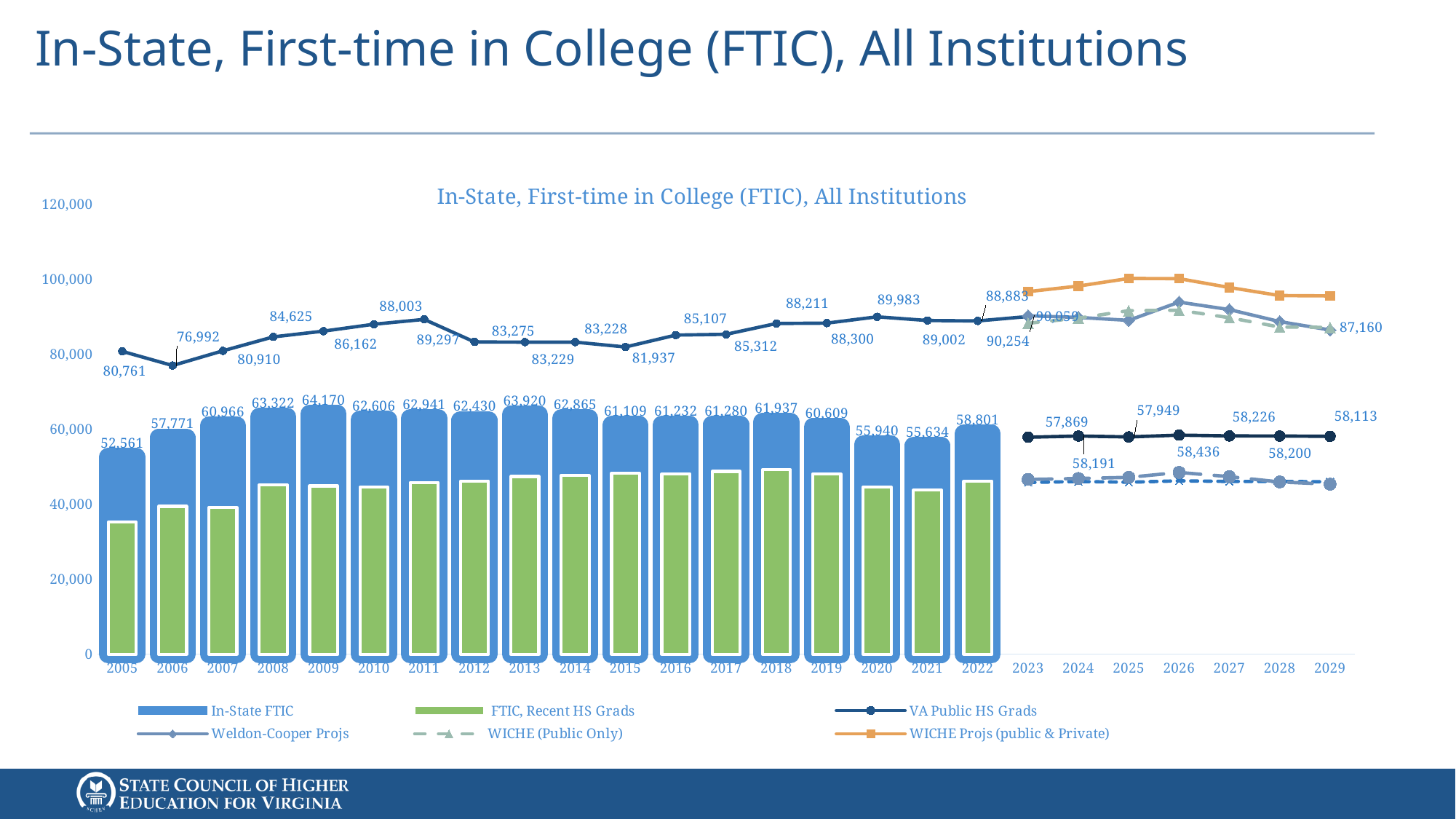
What is the VA Public HS Grads value for 2006? 76,992 What is the difference between the In-State FTIC values for 2009 and 2005? 11,609 In which year is the In-State FTIC value lowest? 2005 Does the In-State FTIC value rise or fall from 2018 to 2021? fall How many series does the legend list? 6 What is the In-State FTIC value for 2005? 52,561 What is the In-State FTIC value for 2022? 58,801 Is the FTIC, Recent HS Grads value for 2005 greater or less than 40,000? less What is the VA Public HS Grads value for 2011? 89,297 Which year has the larger In-State FTIC value, 2020 or 2021? 2020 In which year is the In-State FTIC value highest? 2009 What kind of chart is shown on the slide? Combined bar and line chart